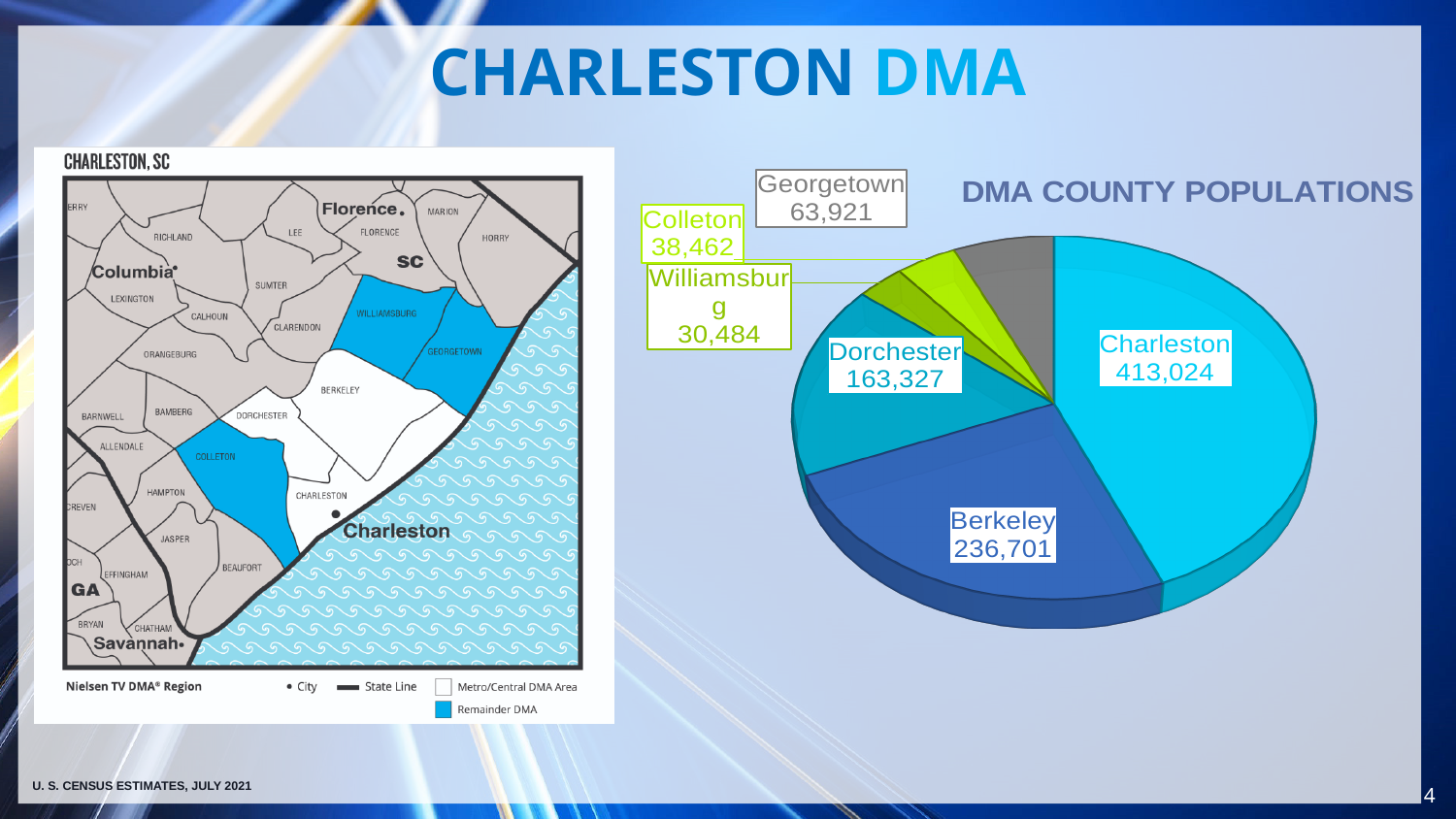
What type of chart is the DMA County Populations chart? Pie chart What is the title of the pie chart on the slide? DMA COUNTY POPULATIONS In the DMA County Populations chart, what is the difference between the populations of Charleston and Berkeley? 176,323 What is the population shown for Charleston in the DMA County Populations chart? 413,024 What is the population shown for Dorchester in the DMA County Populations chart? 163,327 How many counties are shown in the DMA County Populations pie chart? 6 Which county has the smallest population in the DMA County Populations chart? Williamsburg In the DMA County Populations chart, what is the difference between the populations of Georgetown and Colleton? 25,459 What is the population shown for Williamsburg in the DMA County Populations chart? 30,484 In the DMA County Populations chart, which has a larger population, Dorchester or Georgetown? Dorchester What is the population shown for Berkeley in the DMA County Populations chart? 236,701 Which county has the largest population in the DMA County Populations chart? Charleston